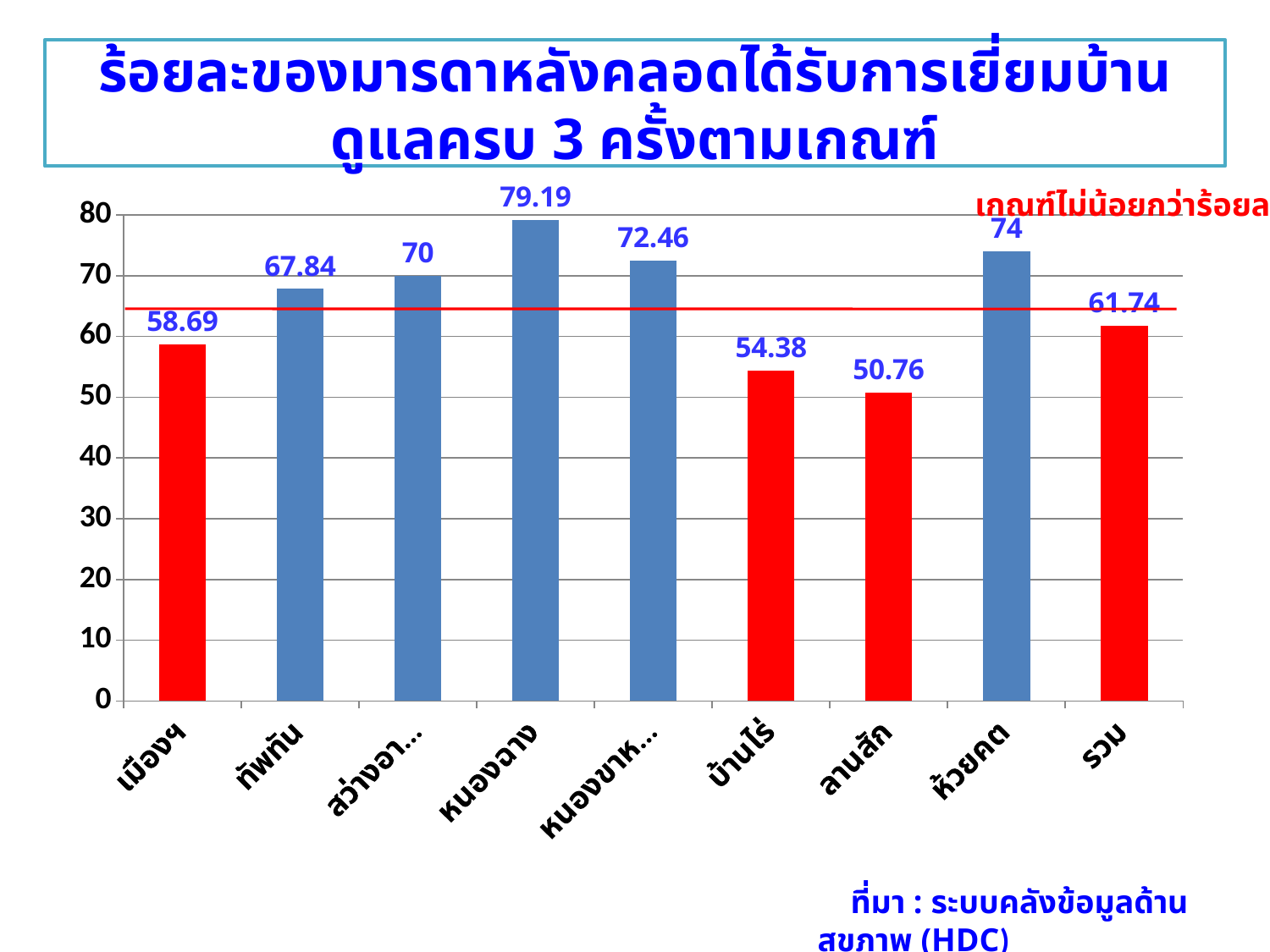
What is the value for หนองฉาง? 79.19 What is the value for ลานสัก? 50.76 Which category has the lowest value? ลานสัก What kind of chart is shown on the slide? bar chart Which category has the highest value? หนองฉาง Which is larger, the value for ทัพทัน or the value for บ้านไร่? ทัพทัน What is the difference between the values for หนองฉาง and ลานสัก? 28.43 How many bars are shown in the chart? 9 What is the value for ห้วยคต? 74 Is the value for เมืองฯ greater or less than 60? less How many bars are coloured red? 4 What is the value for รวม? 61.74